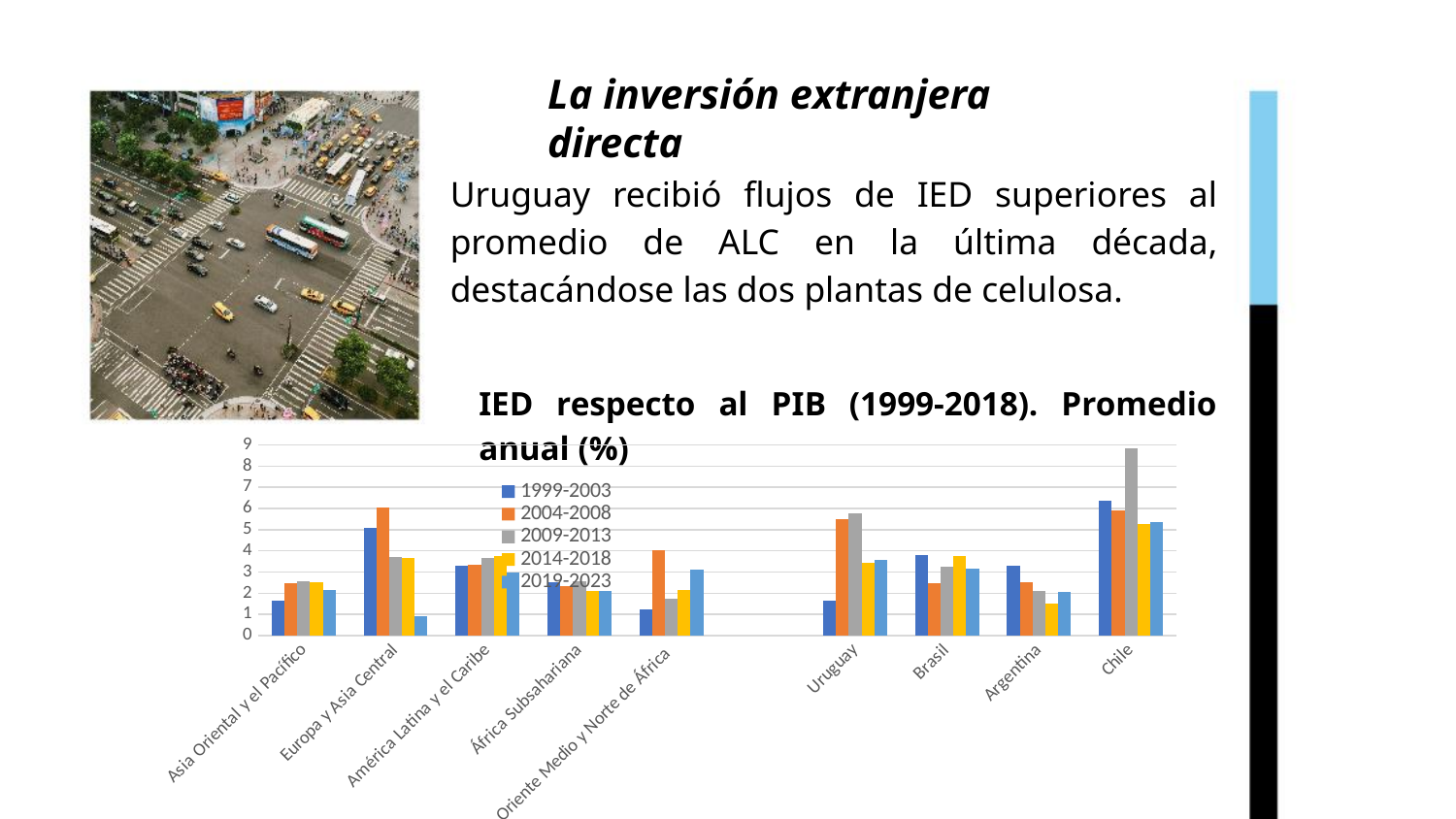
Which series has the lowest value for Europa y Asia Central? 2019-2023 How many categories are shown along the x axis of the chart? 9 Which series has the highest value for Chile? 2009-2013 Is the 2004-2008 value for Uruguay greater or less than 5? greater Which is larger, the 2004-2008 value for Uruguay or the 2004-2008 value for Brasil? Uruguay What kind of chart is shown on the slide? bar chart Which is larger, the 1999-2003 value for Chile or the 1999-2003 value for Uruguay? Chile What is the title of the chart? IED respecto al PIB (1999-2018). Promedio anual (%) Is the 2009-2013 value for Chile greater or less than 8? greater Which category has the tallest bar in the chart? Chile How many series does the legend of the chart list? 5